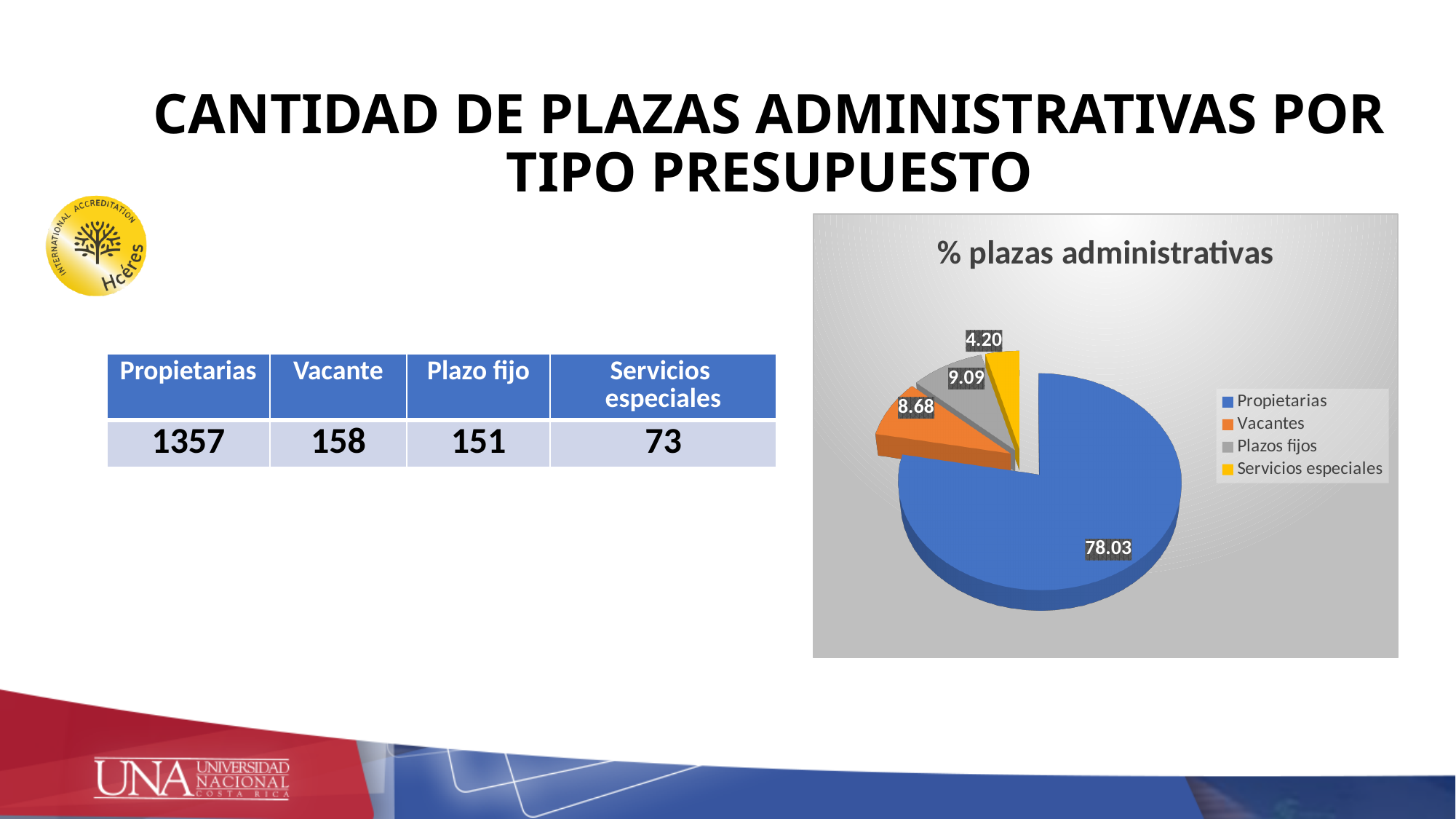
What is the difference between the Propietarias value and the Plazos fijos value? 68.94 What is the title of the chart? % plazas administrativas What value is shown for the Servicios especiales slice? 4.20 What value is shown for the Propietarias slice? 78.03 What type of chart is shown on the slide? pie chart How many entries does the legend list? 4 Which category has the smallest slice of the pie? Servicios especiales Which is larger, the Plazos fijos value or the Vacantes value? Plazos fijos What value is shown for the Vacantes slice? 8.68 How many slices does the pie chart have? 4 Which category has the largest slice of the pie? Propietarias What value is shown for the Plazos fijos slice? 9.09